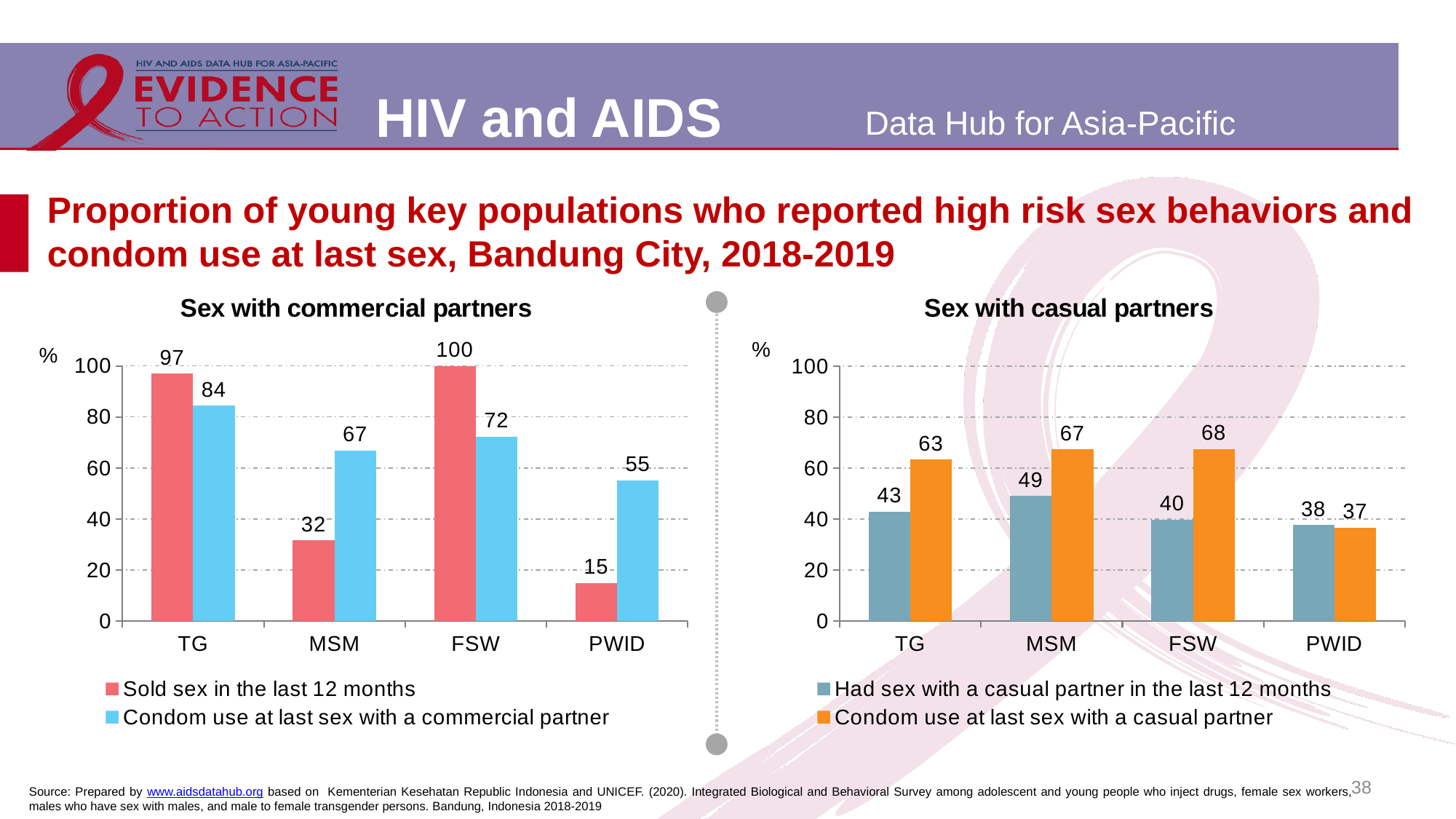
In the 'Sex with casual partners' chart, which group has the highest value for 'Had sex with a casual partner in the last 12 months'? MSM How many groups are shown on the x axis of the 'Sex with casual partners' chart? 4 In the 'Sex with commercial partners' chart, which group has the lowest value for 'Sold sex in the last 12 months'? PWID In the 'Sex with casual partners' chart, which is larger for FSW: 'Had sex with a casual partner in the last 12 months' or 'Condom use at last sex with a casual partner'? Condom use at last sex with a casual partner How many series does the legend of the 'Sex with commercial partners' chart list? 2 In the 'Sex with commercial partners' chart, what is the value for 'Condom use at last sex with a commercial partner' for MSM? 67 In the 'Sex with commercial partners' chart, what is the value for 'Sold sex in the last 12 months' for FSW? 100 In the 'Sex with casual partners' chart, what colour are the bars for 'Condom use at last sex with a casual partner'? Orange In the 'Sex with casual partners' chart, what is the value for 'Condom use at last sex with a casual partner' for TG? 63 In the 'Sex with commercial partners' chart, what is the difference between the two values for PWID? 40 In the 'Sex with commercial partners' chart, is the value for 'Sold sex in the last 12 months' for MSM greater or less than 40? less What kind of chart is the 'Sex with casual partners' chart? Bar chart